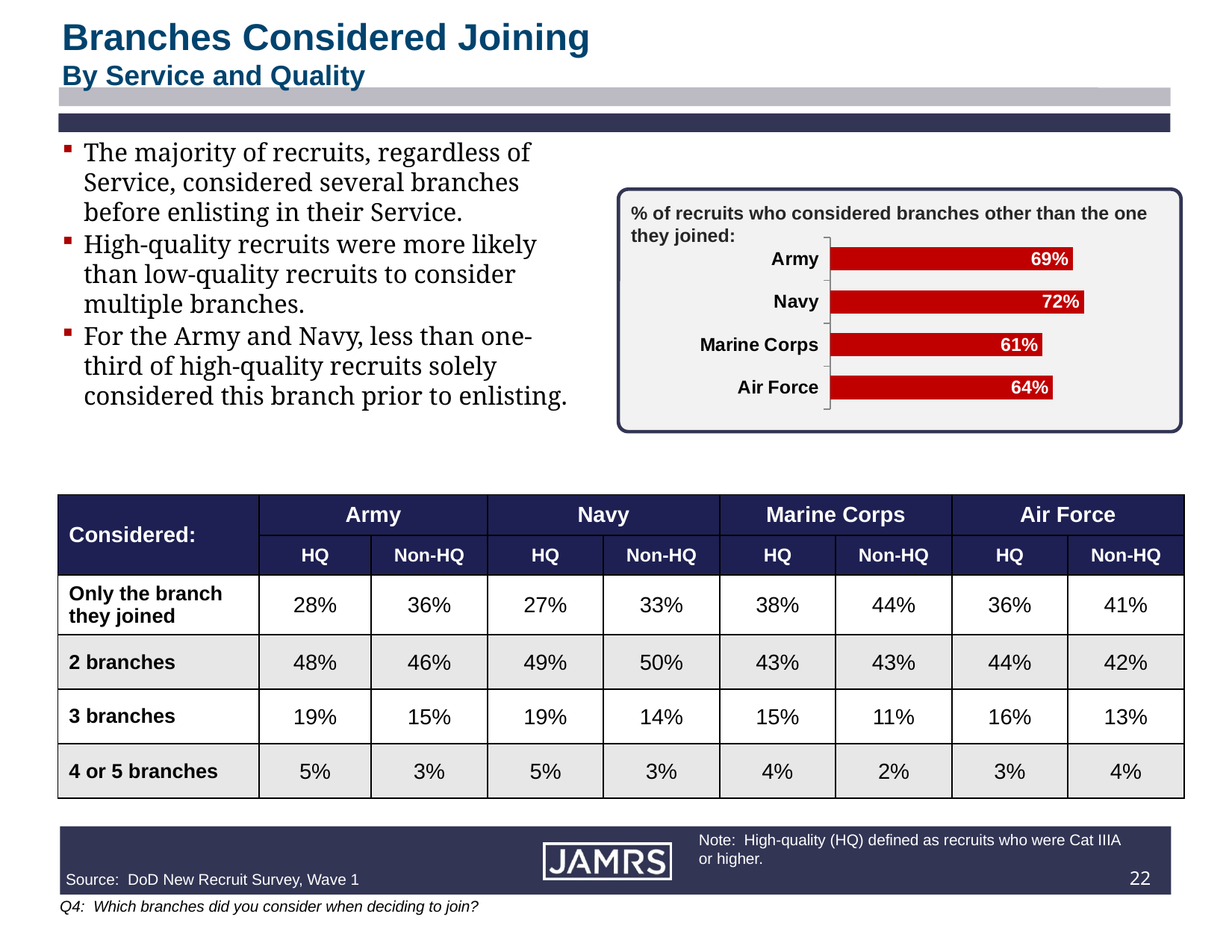
How many Services are shown in the bar chart? 4 What colour are the bars in the chart? Red What percentage of Navy recruits considered branches other than the one they joined? 72% Which Service has the highest percentage of recruits who considered other branches? Navy What is the difference in percentage points between the Army and Air Force values in the chart? 5 Which Service has the lowest percentage of recruits who considered other branches? Marine Corps What percentage of Air Force recruits considered branches other than the one they joined? 64% Which is larger in the chart, the value for Army or the value for Air Force? Army What is the difference in percentage points between the Navy and Marine Corps values in the chart? 11 What type of chart is used to show the percentage of recruits who considered other branches? Bar chart What percentage of Marine Corps recruits considered branches other than the one they joined? 61% What percentage of Army recruits considered branches other than the one they joined? 69%